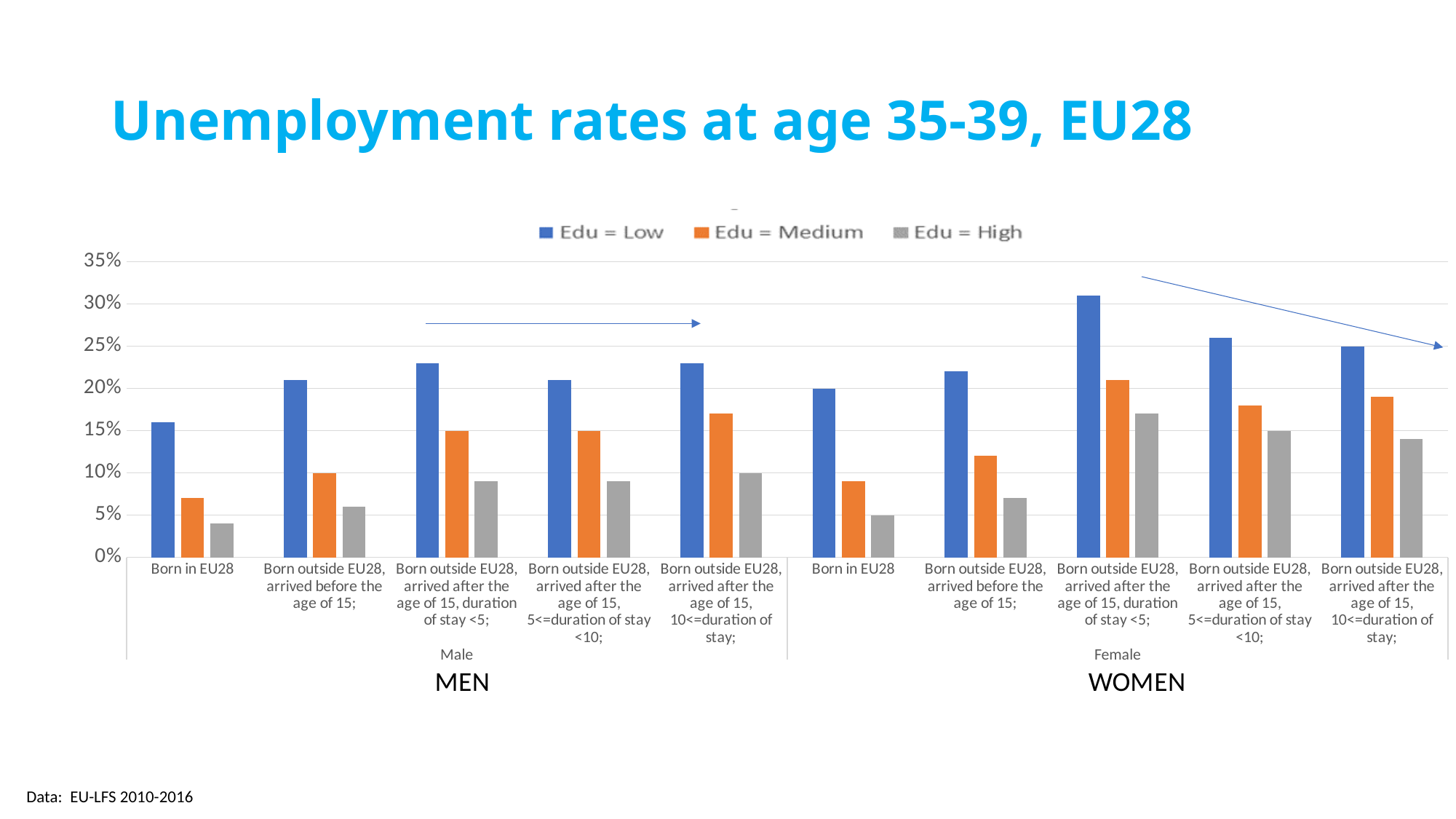
What data source is cited at the bottom of the slide? EU-LFS 2010-2016 Within every category, which education level has the highest unemployment rate? Edu = Low Is the Edu = Low value for women born in EU28 larger or smaller than the Edu = Low value for men born in EU28? larger What kind of chart is shown on the slide? Bar chart What are the three series named in the legend? Edu = Low, Edu = Medium, Edu = High Is the Edu = Medium value for women born outside EU28 who arrived after the age of 15 with duration of stay <5 greater or less than 20%? greater Which category has the highest Edu = Low unemployment rate? Women, born outside EU28, arrived after the age of 15, duration of stay <5 Is the Edu = High value for men born in EU28 greater or less than 5%? less How many series does the legend list? 3 Which category has the lowest Edu = High unemployment rate? Men, born in EU28 How many category groups are plotted along the x axis in total (men and women combined)? 10 Is the Edu = Low value for women born outside EU28 who arrived after the age of 15 with duration of stay <5 greater or less than 30%? greater